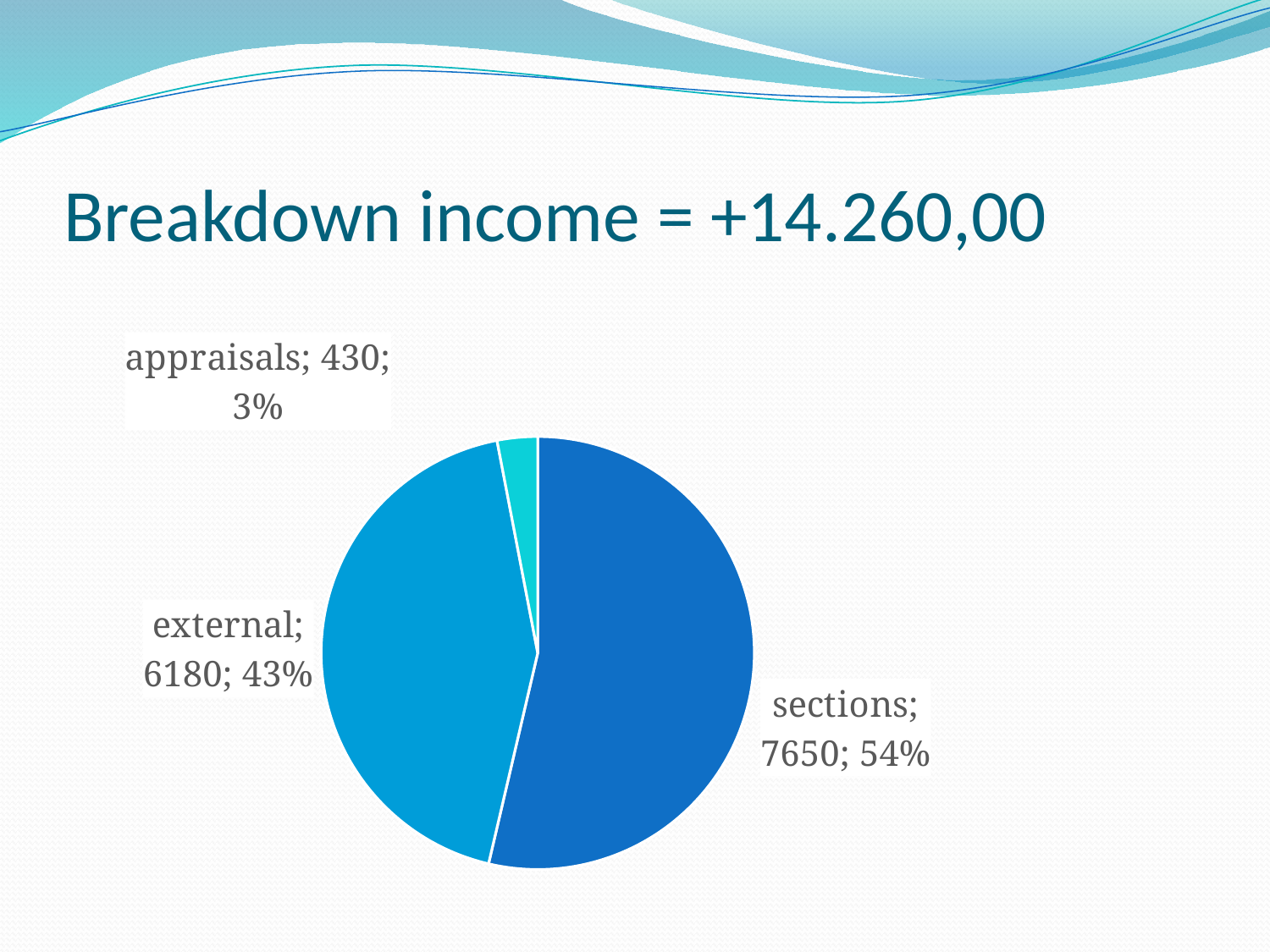
What is the value for external? 6180 What share of the pie does the sections slice represent? 54% What kind of chart is shown on the slide? pie chart What share of the pie does the appraisals slice represent? 3% What share of the pie does the external slice represent? 43% How many slices does the pie chart have? 3 Which category has the largest slice? sections What is the value for sections? 7650 Which category has the smallest slice? appraisals What is the value for appraisals? 430 Which is larger, the value for external or the value for appraisals? external What is the difference between the values for sections and external? 1470